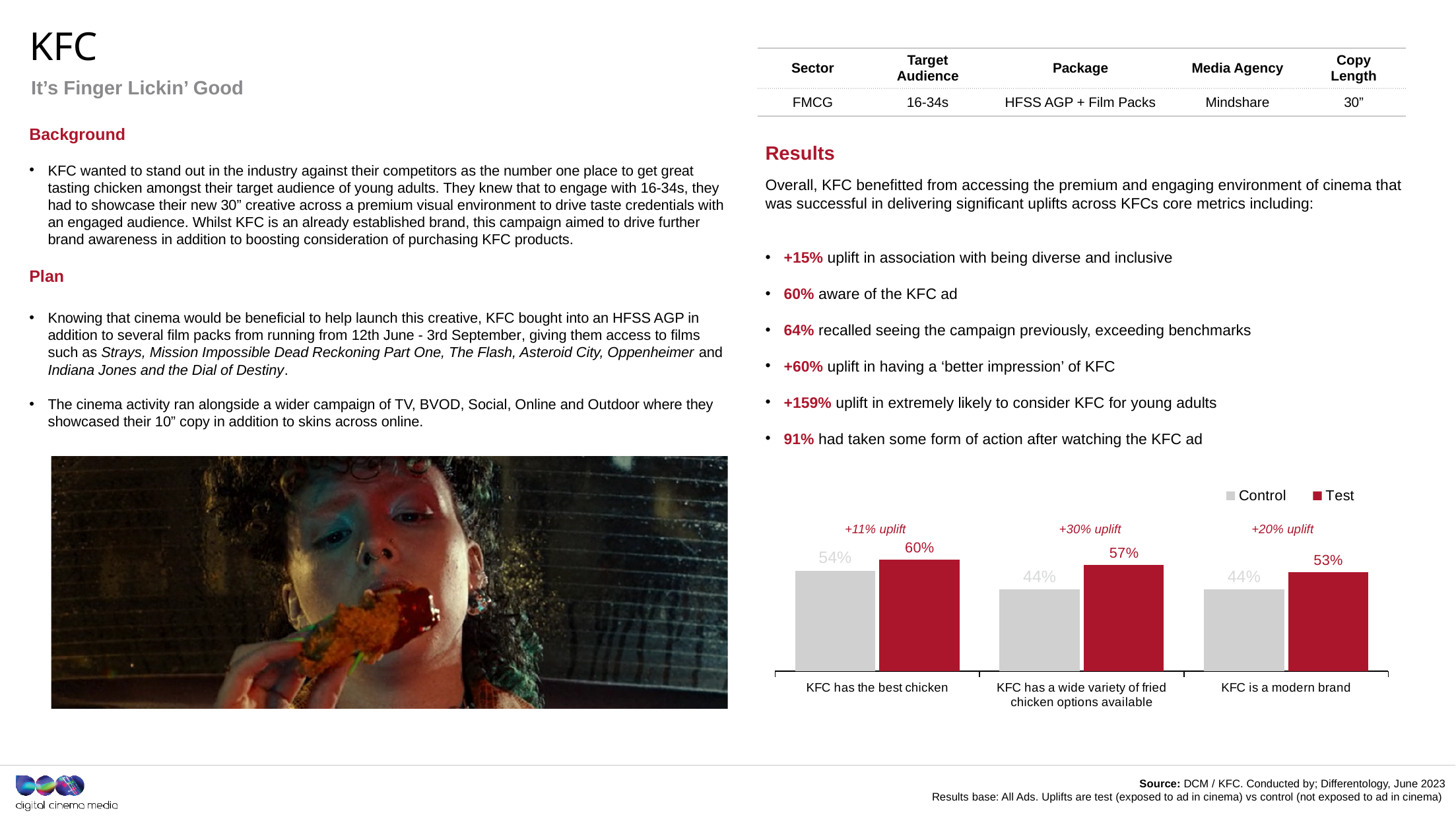
What is the difference between the Test and Control values for 'KFC has a wide variety of fried chicken options available'? 13% Which category has the highest Test value? KFC has the best chicken What uplift is shown above the bars for 'KFC has a wide variety of fried chicken options available'? +30% uplift What is the Test value for 'KFC is a modern brand'? 53% What is the Control value for 'KFC has a wide variety of fried chicken options available'? 44% What kind of chart is shown on the slide? Bar chart What is the Test value for 'KFC has the best chicken'? 60% Which series is shown in red in the chart? Test Which category has the lowest Test value? KFC is a modern brand Which is larger for 'KFC is a modern brand': the Control value or the Test value? Test How many categories are shown on the x axis of the chart? 3 How many series does the chart legend list? 2